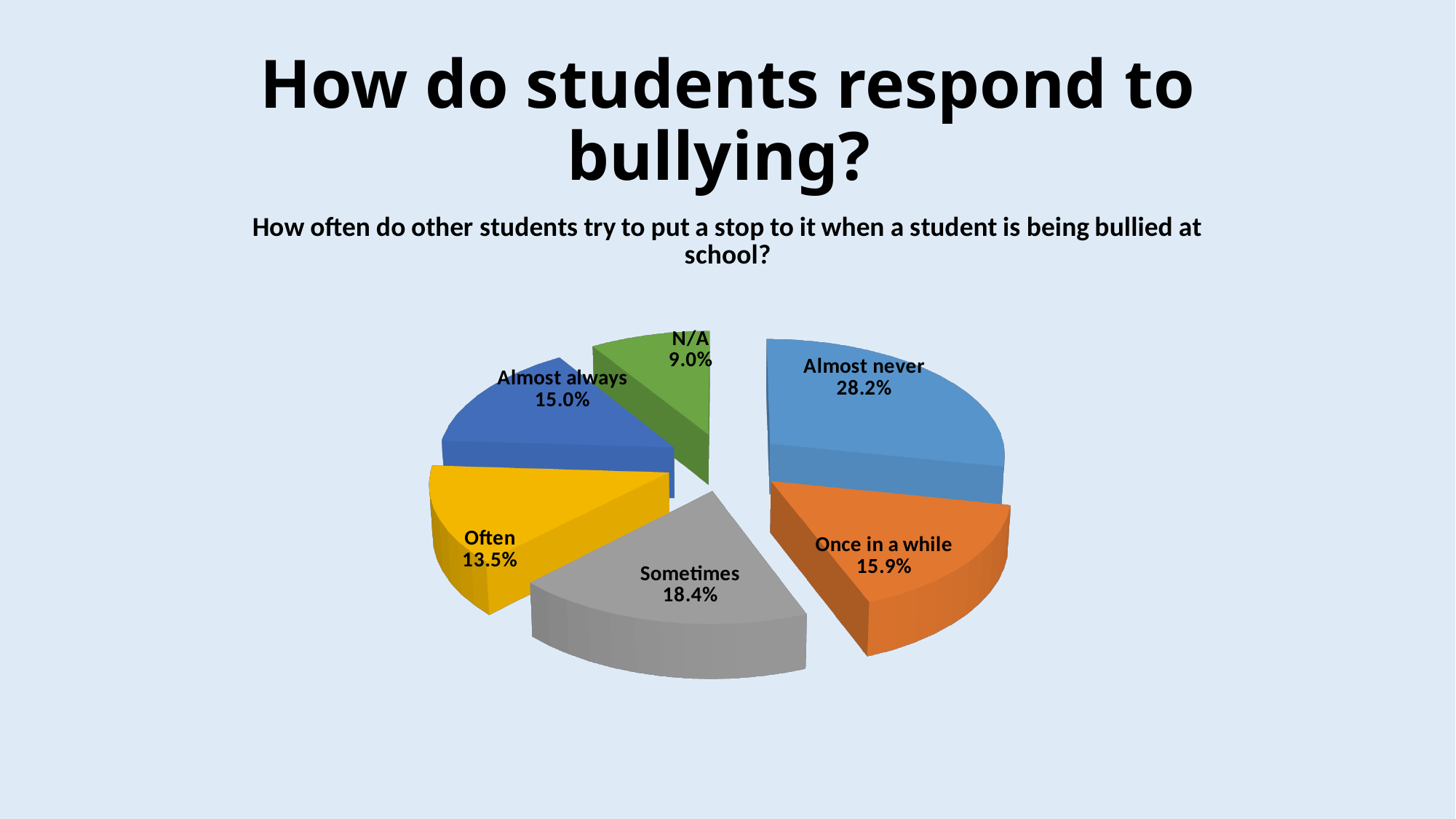
What percentage of responses is 'Often'? 13.5% What percentage of responses is 'Sometimes'? 18.4% What is the title of the chart? How often do other students try to put a stop to it when a student is being bullied at school? How many categories (slices) does the pie chart have? 6 What is the difference in percentage points between 'Almost never' and 'Sometimes'? 9.8 Which is larger, 'Once in a while' or 'Almost always'? Once in a while What kind of chart is shown on the slide? Pie chart What percentage of responses is 'Almost never'? 28.2% What percentage of responses is 'N/A'? 9.0% What is the difference in percentage points between 'Almost always' and 'Often'? 1.5 Which category has the largest share of the pie? Almost never Which category has the smallest share of the pie? N/A